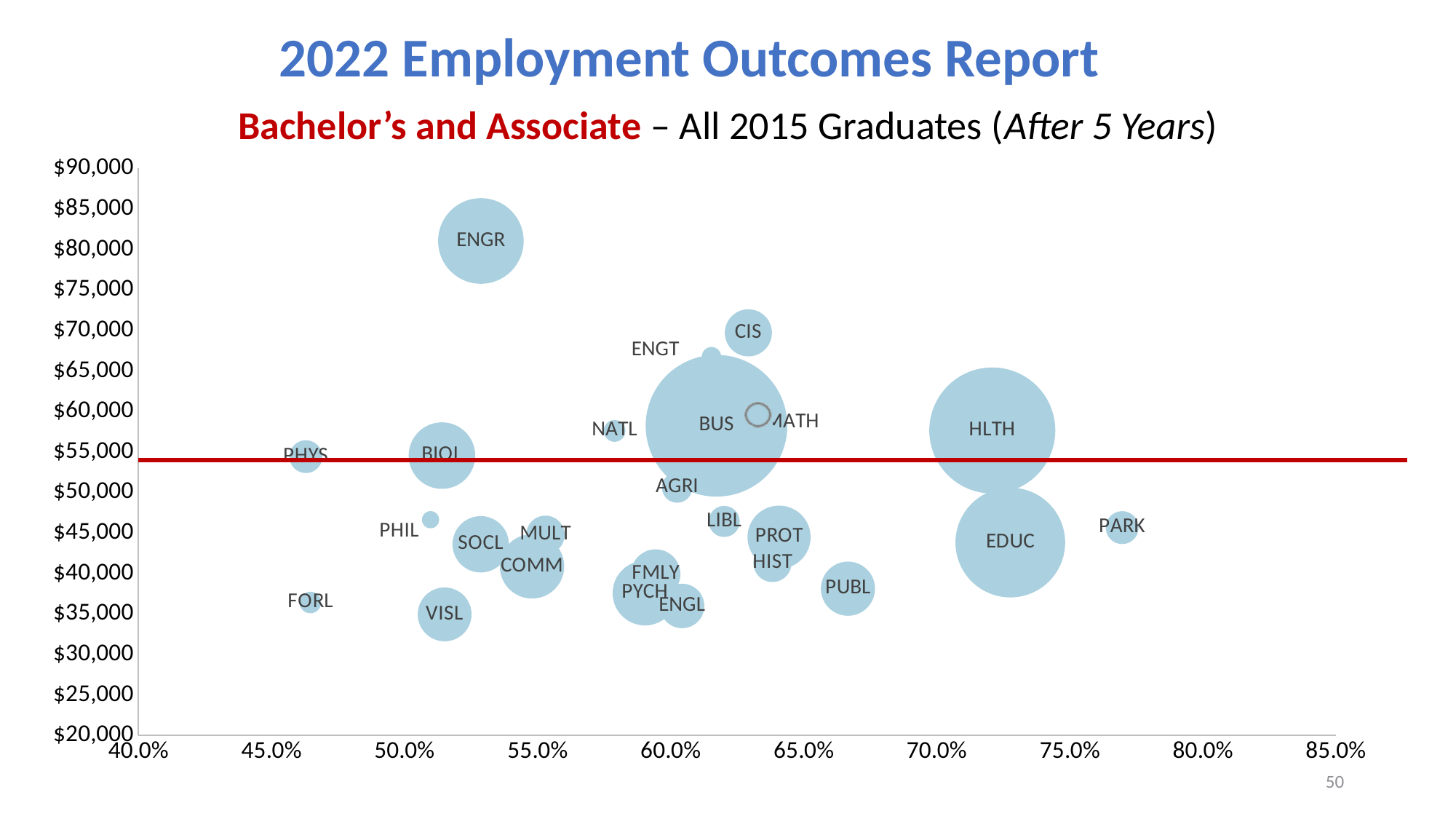
Is the value for EDUC on the vertical axis greater or less than $45,000? less Is the value for PUBL on the vertical axis greater or less than $40,000? less Which has the higher vertical-axis value, HLTH or EDUC? HLTH What kind of chart is shown on the slide? Bubble chart Which major is positioned furthest to the right on the horizontal (percentage) axis? PARK Which major has the highest value on the vertical (salary) axis? ENGR Which has the higher vertical-axis value, ENGR or CIS? ENGR Is the value for ENGR on the vertical axis greater or less than $75,000? greater What is the title shown at the top of the slide? 2022 Employment Outcomes Report What is the highest value labelled on the vertical axis? $90,000